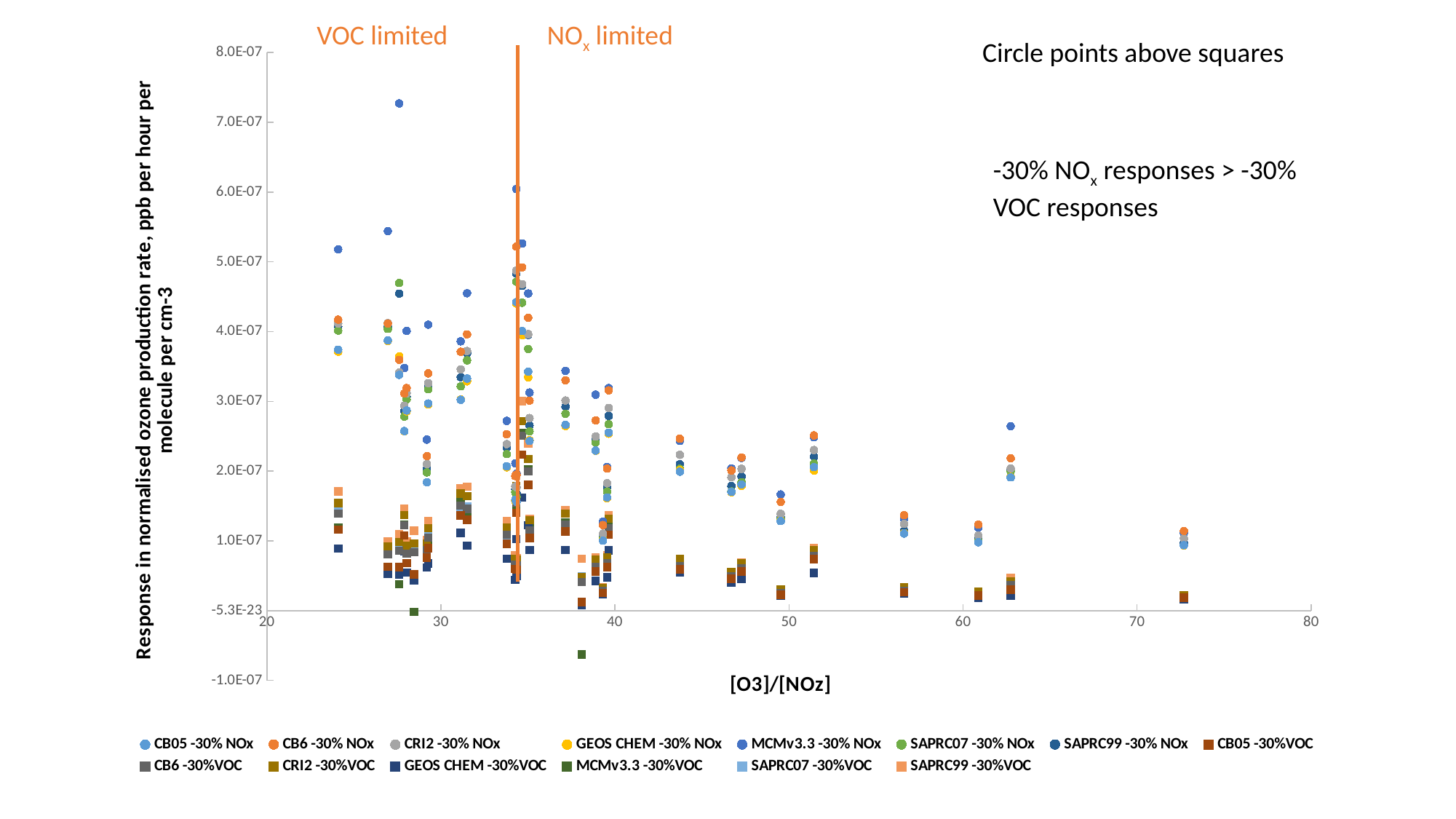
Is the lowest plotted point on the chart above or below the -5.3E-23 axis line? below What kind of chart is shown on the slide? Scatter chart What is the largest value shown on the x axis? 80 Do the plotted responses generally rise or fall as [O3]/[NOz] increases along the x axis? fall Which series has the single lowest plotted point on the chart? MCMv3.3 -30%VOC Is the highest plotted point on the chart greater or less than 7.0E-07? greater What is the highest value shown on the y axis? 8.0E-07 What is the label of the x axis? [O3]/[NOz] Is the highest plotted point on the chart greater or less than 8.0E-07? less Which series has the single highest plotted point on the chart? MCMv3.3 -30% NOx Which group of points is generally higher on the chart: the -30% NOx circles or the -30% VOC squares? -30% NOx circles How many series does the chart legend list? 14